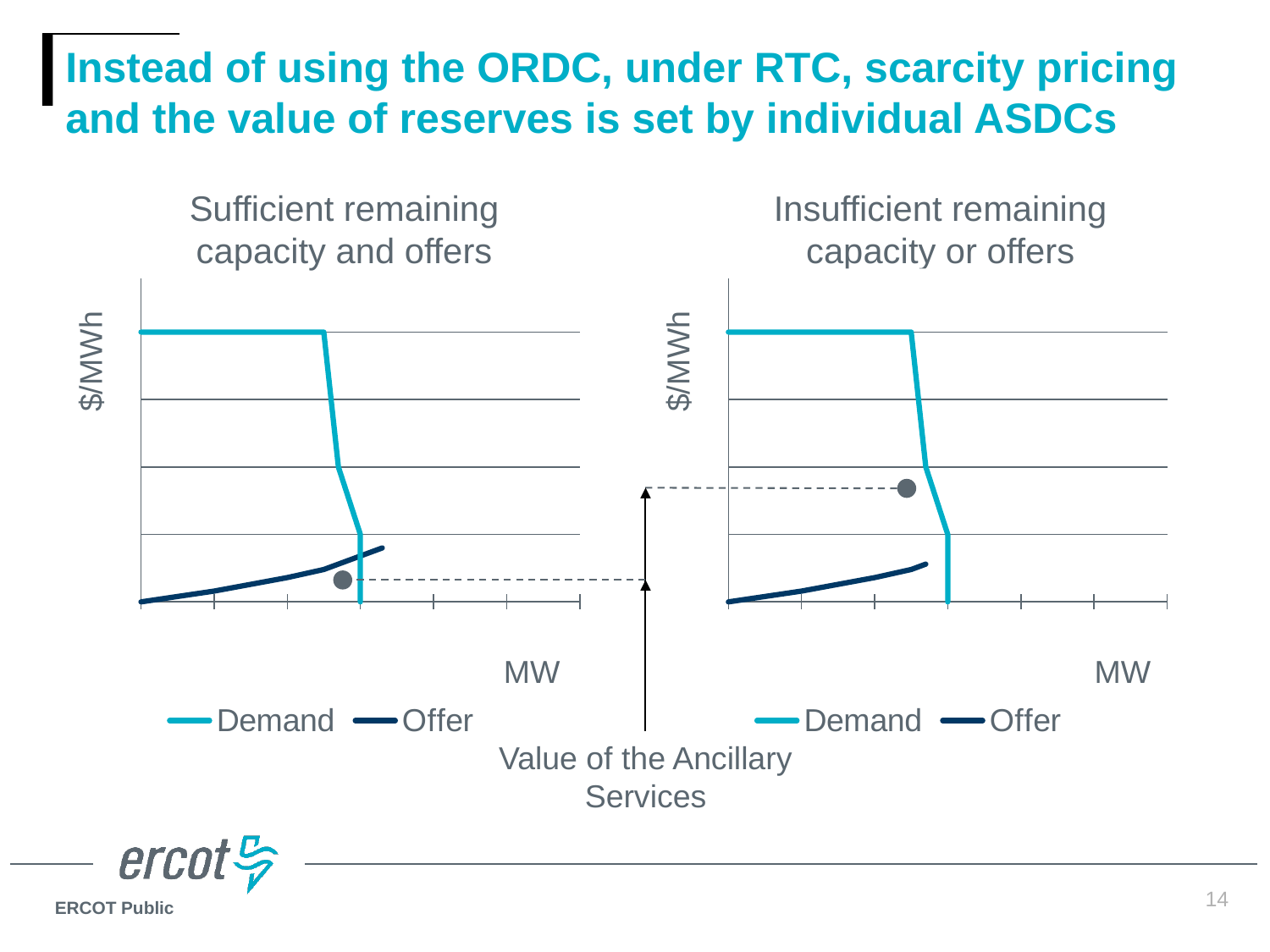
What kind of chart is the left chart titled "Sufficient remaining capacity and offers"? Line chart In the left chart ("Sufficient remaining capacity and offers"), does the Offer series rise or fall as MW increases? Rise In the left chart ("Sufficient remaining capacity and offers"), does the Demand series rise or fall as MW increases? Fall How many series does the legend of the right chart ("Insufficient remaining capacity or offers") list? 2 What are the two series named in the legend of the left chart ("Sufficient remaining capacity and offers")? Demand and Offer In the right chart ("Insufficient remaining capacity or offers"), does the Demand series rise or fall as MW increases? Fall How many series does the legend of the left chart ("Sufficient remaining capacity and offers") list? 2 What kind of chart is the right chart titled "Insufficient remaining capacity or offers"? Line chart What is the y-axis label of the right chart ("Insufficient remaining capacity or offers")? $/MWh